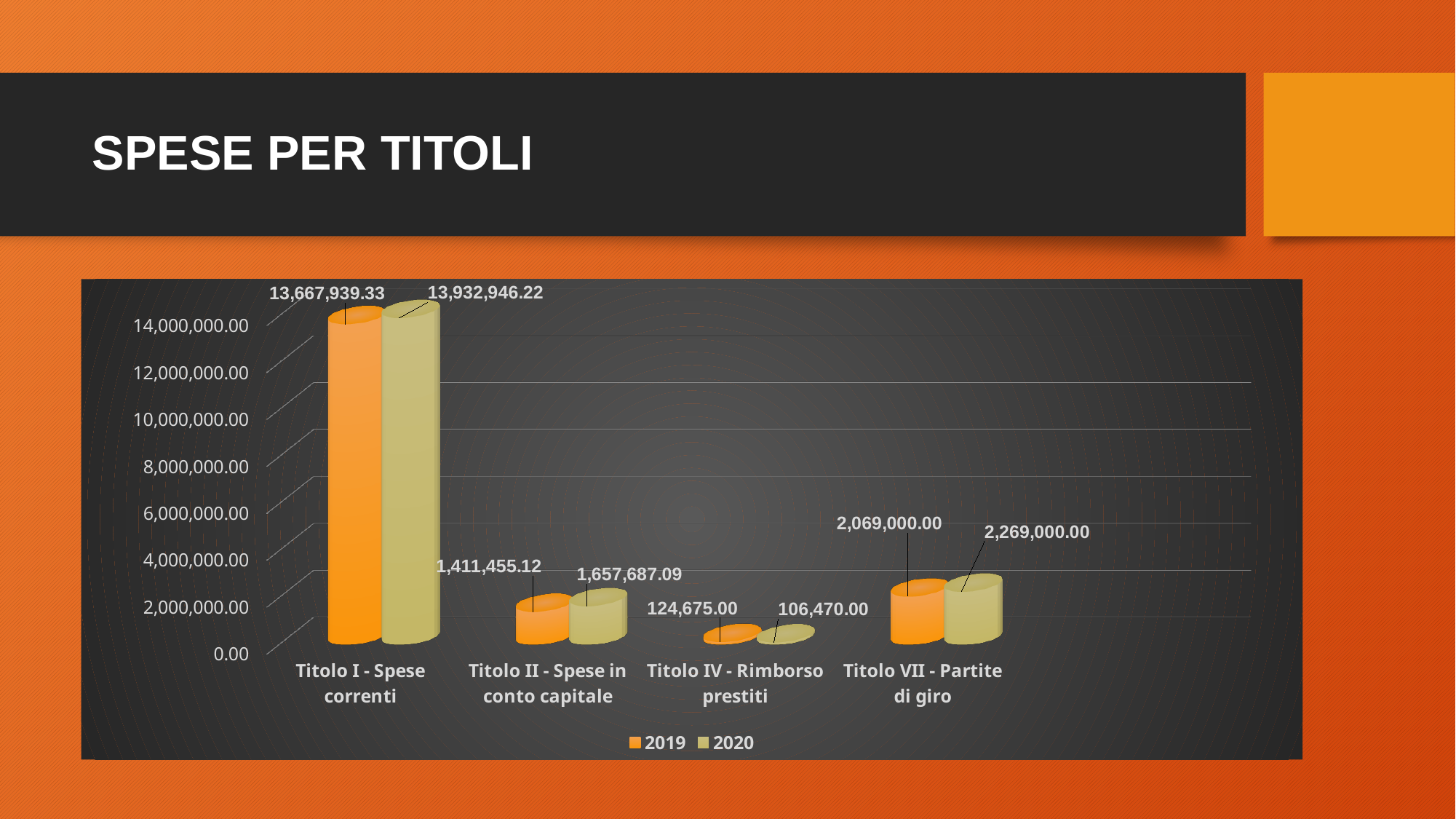
For Titolo IV - Rimborso prestiti, which year has the larger value, 2019 or 2020? 2019 What is the 2019 value for Titolo IV - Rimborso prestiti? 124,675.00 What is the 2020 value for Titolo VII - Partite di giro? 2,269,000.00 Which category has the lowest 2019 value? Titolo IV - Rimborso prestiti What is the 2020 value for Titolo II - Spese in conto capitale? 1,657,687.09 What is the difference between the 2019 and 2020 values for Titolo IV - Rimborso prestiti? 18,205.00 Which category has the highest 2020 value? Titolo I - Spese correnti What kind of chart is shown on the slide? Bar chart How many categories are shown on the x axis? 4 What is the difference between the 2020 and 2019 values for Titolo VII - Partite di giro? 200,000.00 How many series does the legend list? 2 What is the 2019 value for Titolo I - Spese correnti? 13,667,939.33